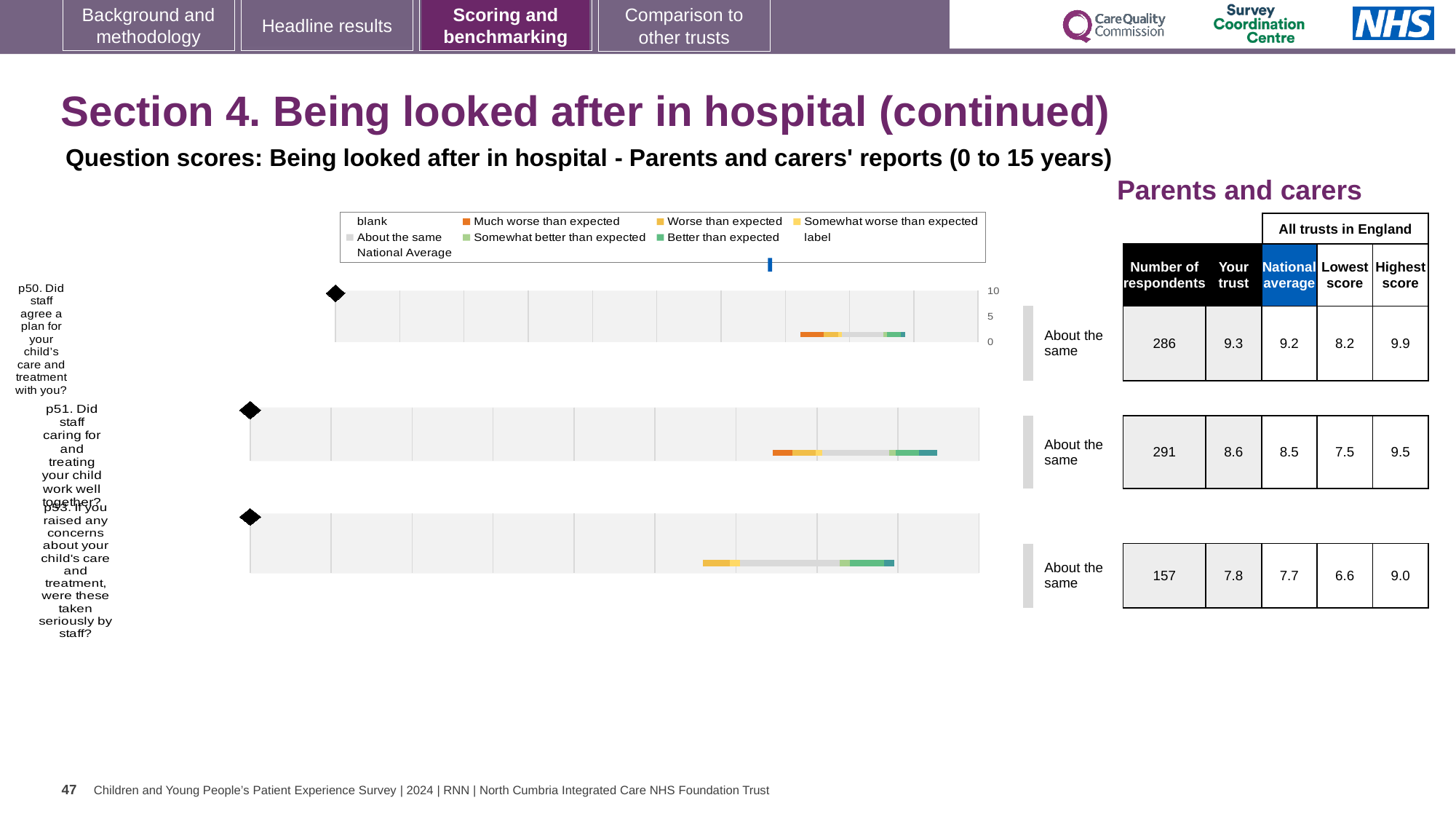
What is the benchmark category shown for p53? About the same For p51, which is larger: the 'Your trust' score or the national average? Your trust What is the difference between the highest score and the lowest score for p50? 1.7 Which question has the lowest 'Your trust' score? p53 How many respondents answered p51 (Did staff caring for and treating your child work well together?)? 291 What kind of chart is used to show each question's score? Bar chart Which question has the highest number of respondents? p51 What is the maximum value shown on the score axis of the p50 chart? 10 What is the highest score across all trusts in England for p51? 9.5 What is the national average score for p53 (If you raised any concerns about your child's care and treatment, were these taken seriously by staff?)? 7.7 How many questions are plotted on the slide? 3 What is the 'Your trust' score for p50 (Did staff agree a plan for your child's care and treatment with you?)? 9.3